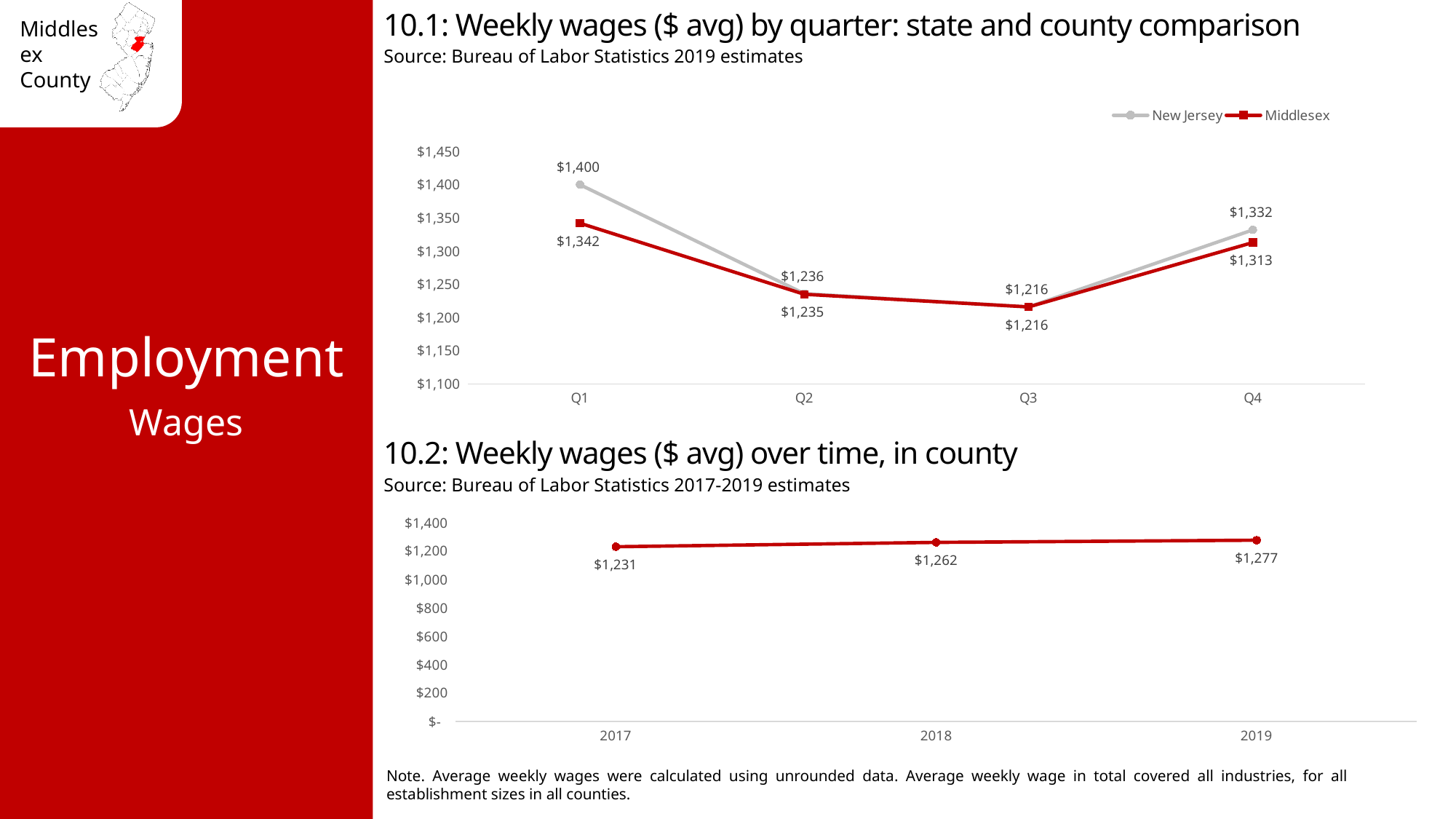
In chart 10.1, which quarter has the highest New Jersey weekly wage? Q1 In chart 10.1, what is the Middlesex weekly wage in Q4? $1,313 In chart 10.1, what type of chart is shown? Line chart In chart 10.1, what is the difference between the New Jersey and Middlesex weekly wages in Q1? $58 In chart 10.1, what is the New Jersey weekly wage in Q1? $1,400 In chart 10.2, what is the difference between the 2019 and 2017 weekly wages? $46 In chart 10.1, which quarter has the lowest Middlesex weekly wage? Q3 In chart 10.1, how many series does the legend list? 2 In chart 10.1, which is larger in Q4: the New Jersey or the Middlesex weekly wage? New Jersey In chart 10.2, what is the weekly wage in 2018? $1,262 In chart 10.2, how many years are plotted? 3 In chart 10.2, do weekly wages rise or fall from 2017 to 2019? Rise